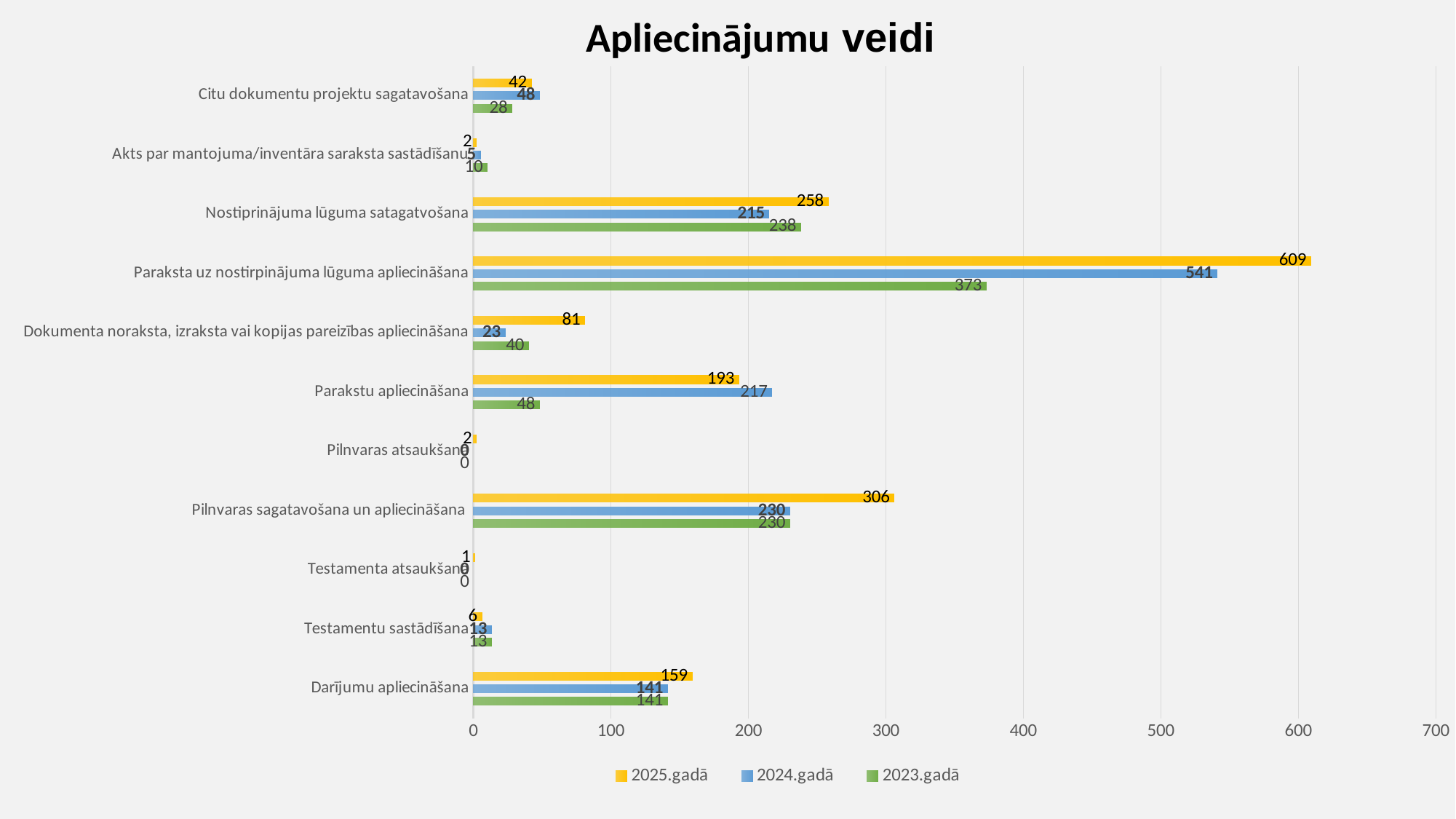
What is the difference between the 2025.gadā and 2024.gadā values for Pilnvaras sagatavošana un apliecināšana? 76 How many categories are shown on the chart? 11 How many series does the legend list? 3 What is the value for Parakstu apliecināšana in 2024.gadā? 217 For Nostiprinājuma lūguma satagatvošana, which is larger: the 2024.gadā value or the 2023.gadā value? 2023.gadā Which category has the highest value in the 2025.gadā series? Paraksta uz nostirpinājuma lūguma apliecināšana What is the value for Paraksta uz nostirpinājuma lūguma apliecināšana in 2025.gadā? 609 What is the title of the chart? Apliecinājumu veidi Which category has the lowest value in the 2025.gadā series? Testamenta atsaukšana What is the value for Darījumu apliecināšana in 2023.gadā? 141 Is the 2023.gadā value for Paraksta uz nostirpinājuma lūguma apliecināšana greater or less than 400? less What type of chart is shown on the slide? bar chart